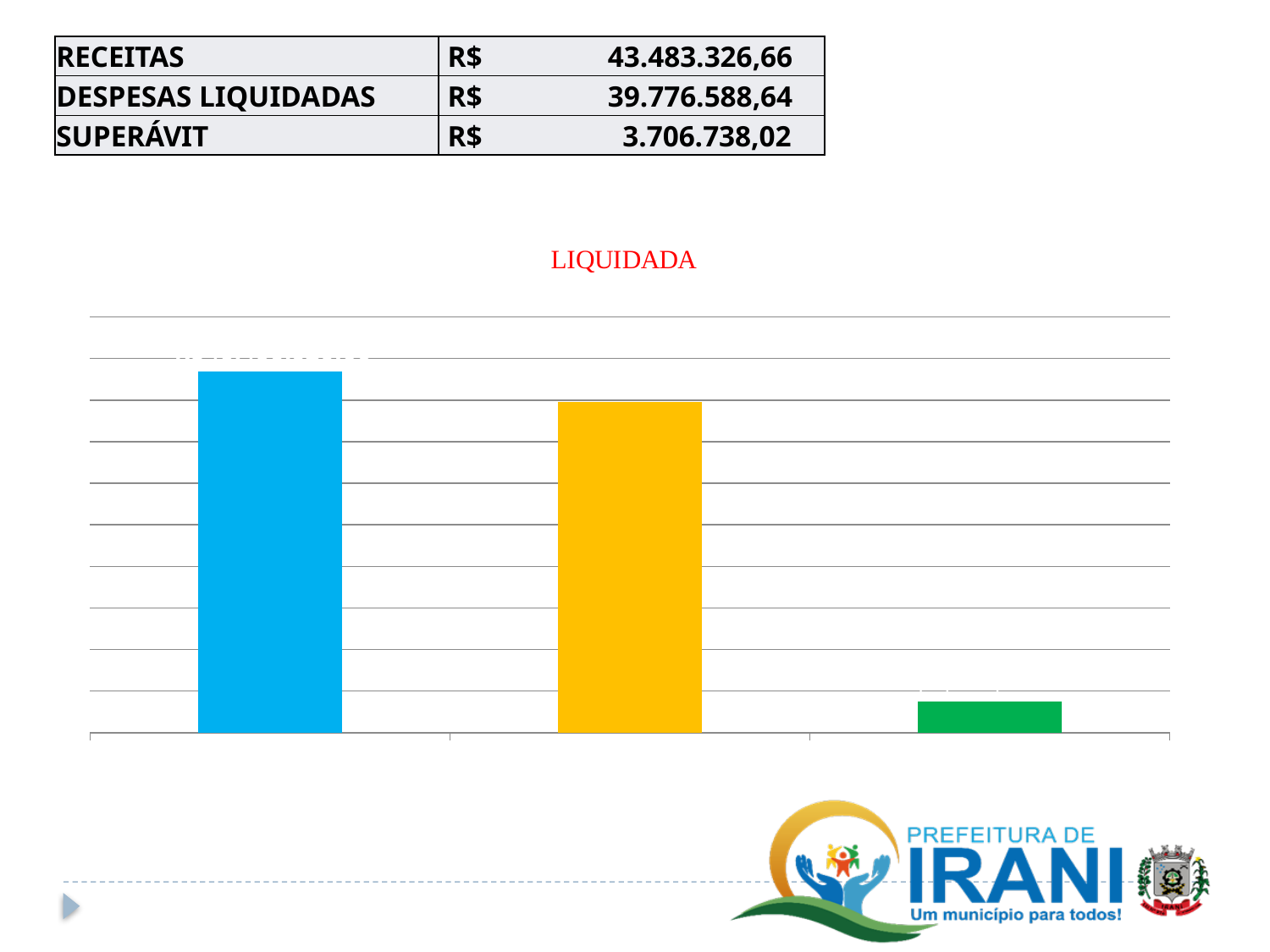
What colours are the three bars in the chart, from left to right? blue, yellow, green Which bar in the chart is the shortest? the green bar (third bar) Do the bar heights rise or fall from left to right across the chart? fall Is the yellow bar or the green bar taller? the yellow bar What is the title of the chart? LIQUIDADA Which bar in the chart is the tallest? the blue bar (first bar) Is the blue bar or the yellow bar taller? the blue bar What kind of chart is shown on the slide? bar chart How many bars does the chart show? 3